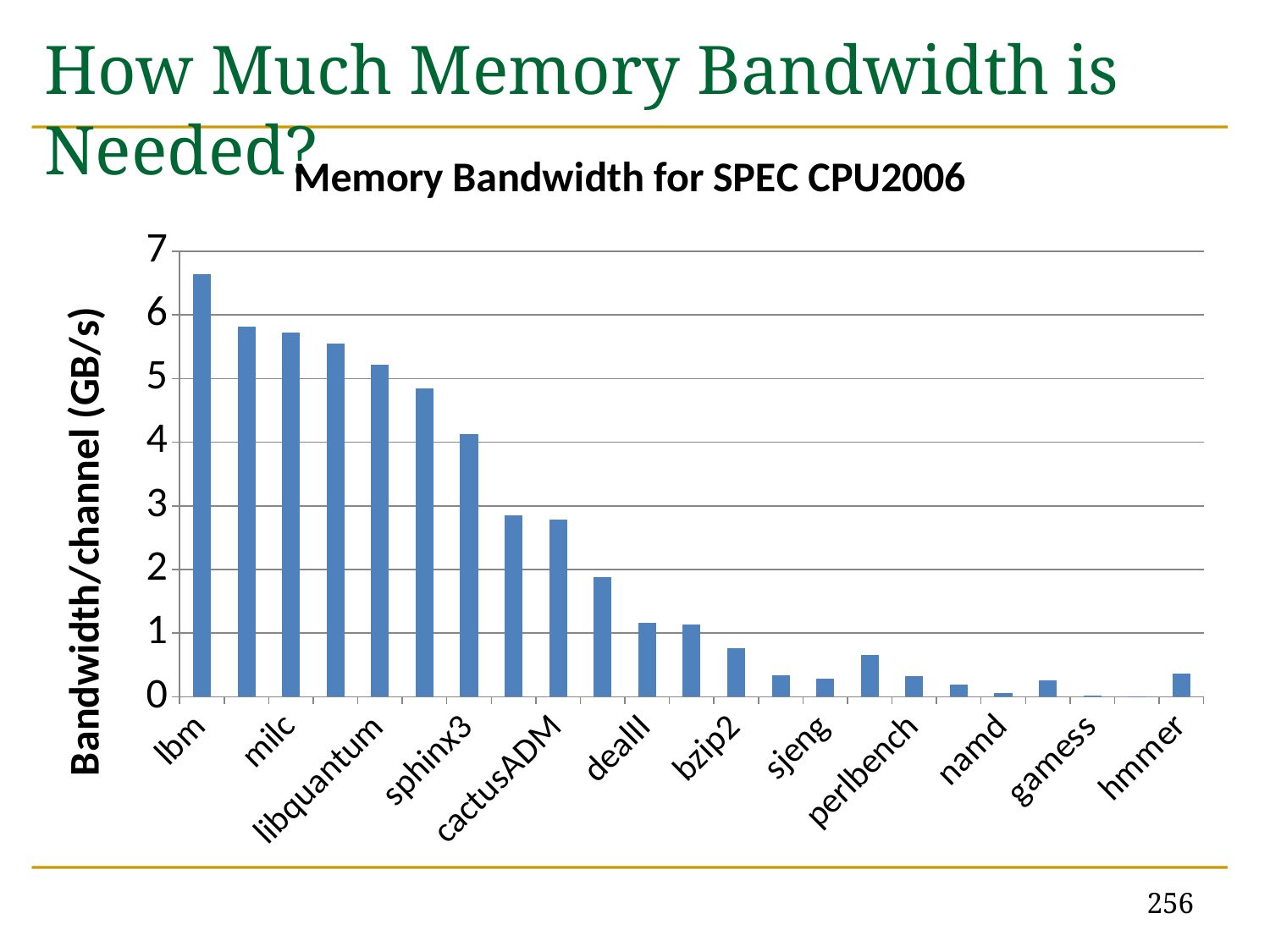
Is the value for cactusADM greater or less than 3? less Which benchmark has the highest memory bandwidth per channel? lbm Is the value for bzip2 greater or less than 1? less What is the label of the vertical axis? Bandwidth/channel (GB/s) What is the title of the chart? Memory Bandwidth for SPEC CPU2006 Do the bandwidth values generally rise or fall moving from left to right across the benchmarks? fall Is the value for milc greater or less than 5? greater What kind of chart is shown on the slide? Bar chart Which has a higher bandwidth per channel, dealII or hmmer? dealII Which has a higher bandwidth per channel, lbm or milc? lbm